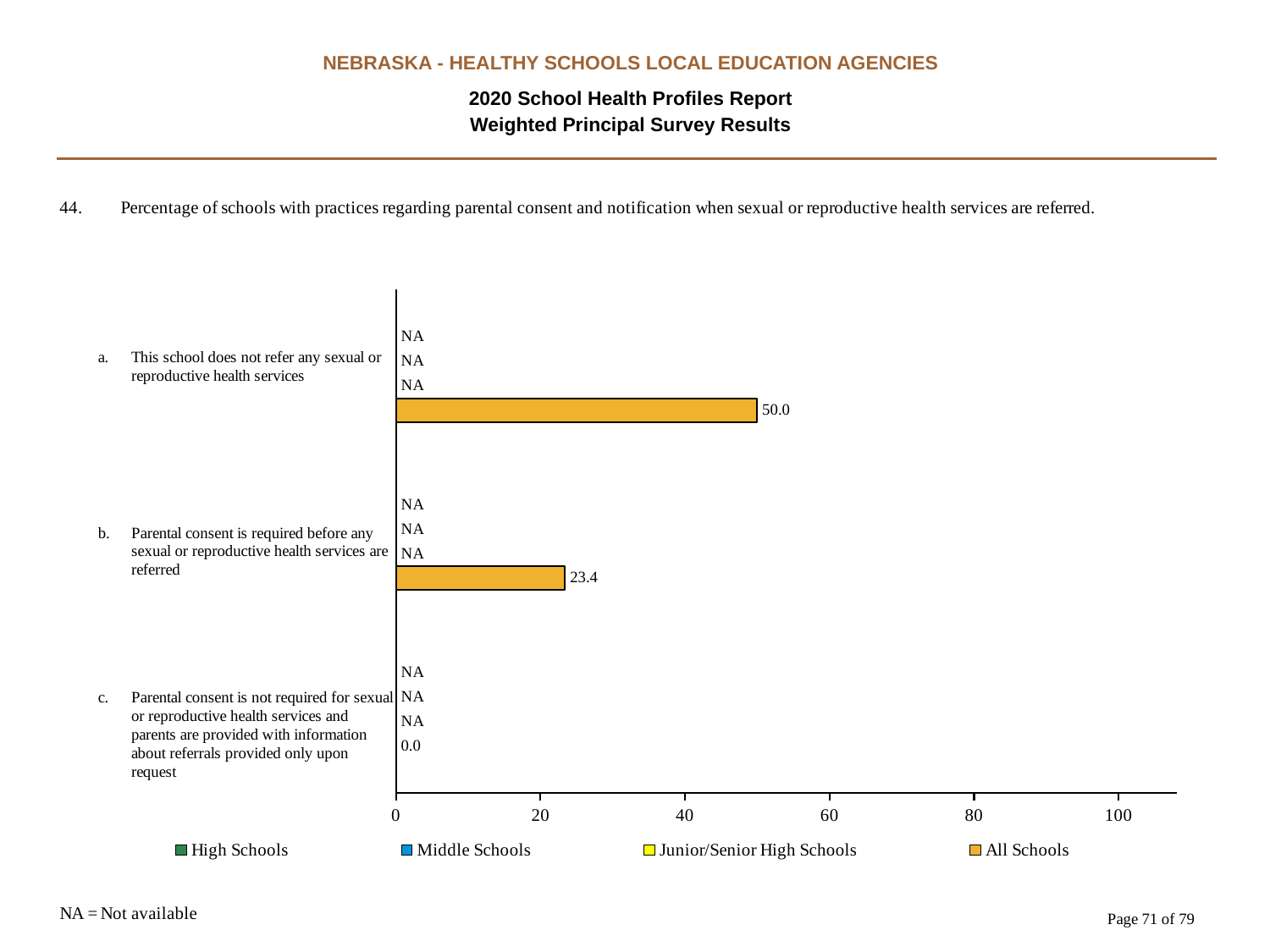
What is the All Schools value for category c, 'Parental consent is not required for sexual or reproductive health services and parents are provided with information about referrals provided only upon request'? 0.0 What kind of chart is shown on the slide? bar chart What is the difference between the All Schools values for category a and category b? 26.6 Which category has the highest All Schools value? a. This school does not refer any sexual or reproductive health services Is the All Schools value for category a larger or smaller than the All Schools value for category b? larger How many categories are shown on the chart? 3 What is shown for High Schools in category a? NA Which category has the lowest All Schools value? c. Parental consent is not required for sexual or reproductive health services and parents are provided with information about referrals provided only upon request What is the All Schools value for category a, 'This school does not refer any sexual or reproductive health services'? 50.0 How many series does the legend list? 4 Is the All Schools value for category b greater or less than 40? less What is the All Schools value for category b, 'Parental consent is required before any sexual or reproductive health services are referred'? 23.4